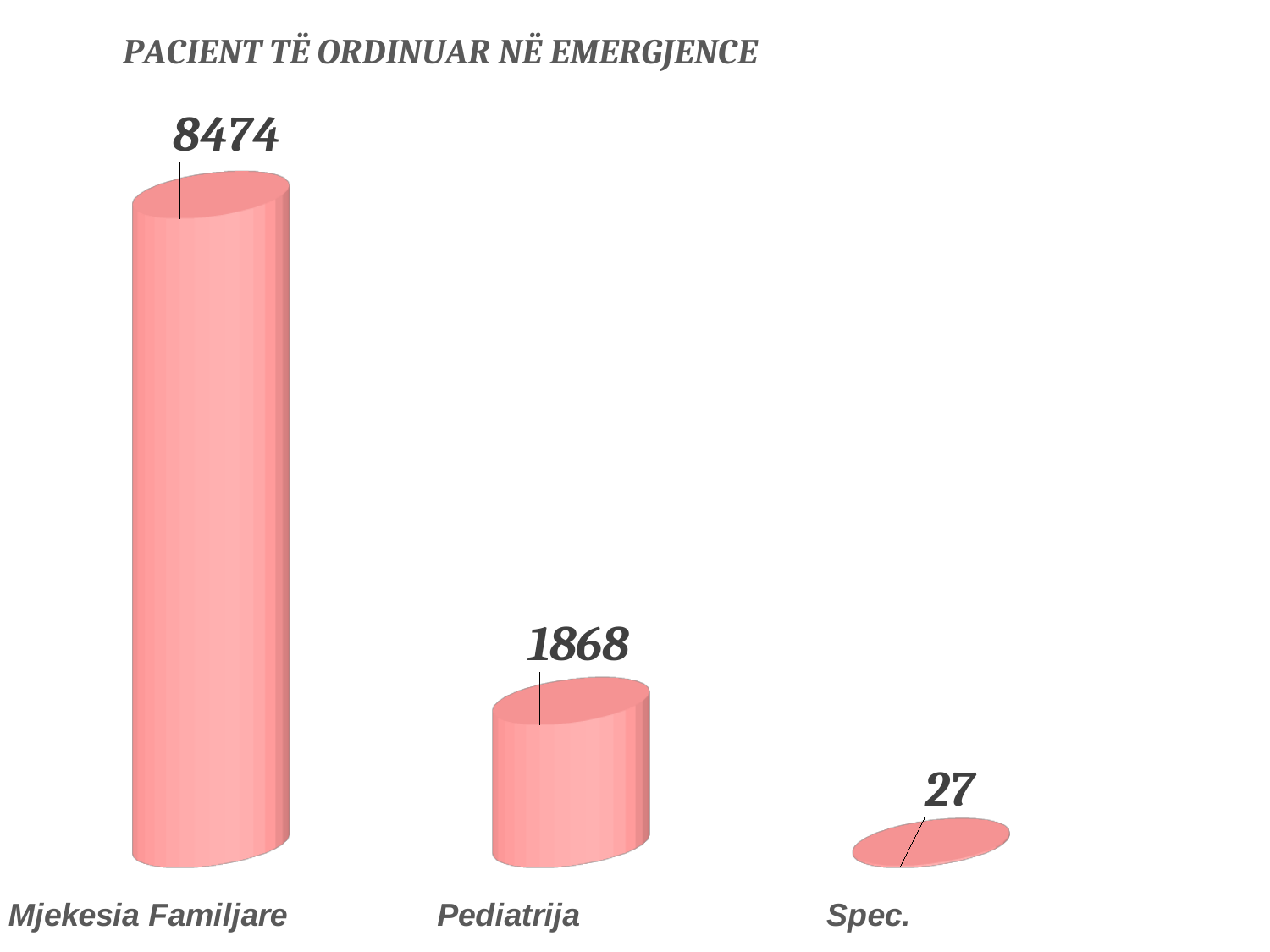
What is the value for Pediatrija? 1868 Do the values rise or fall from left to right across the categories? Fall What is the value for Spec.? 27 What is the difference between the values for Pediatrija and Spec.? 1841 Which category has the highest value? Mjekesia Familjare What is the difference between the values for Mjekesia Familjare and Pediatrija? 6606 Which category has the lowest value? Spec. What kind of chart is shown on the slide? Bar chart How many categories are shown in the chart? 3 What is the title of the chart? PACIENT TË ORDINUAR NË EMERGJENCE Which is larger, the value for Pediatrija or the value for Spec.? Pediatrija What is the value for Mjekesia Familjare? 8474